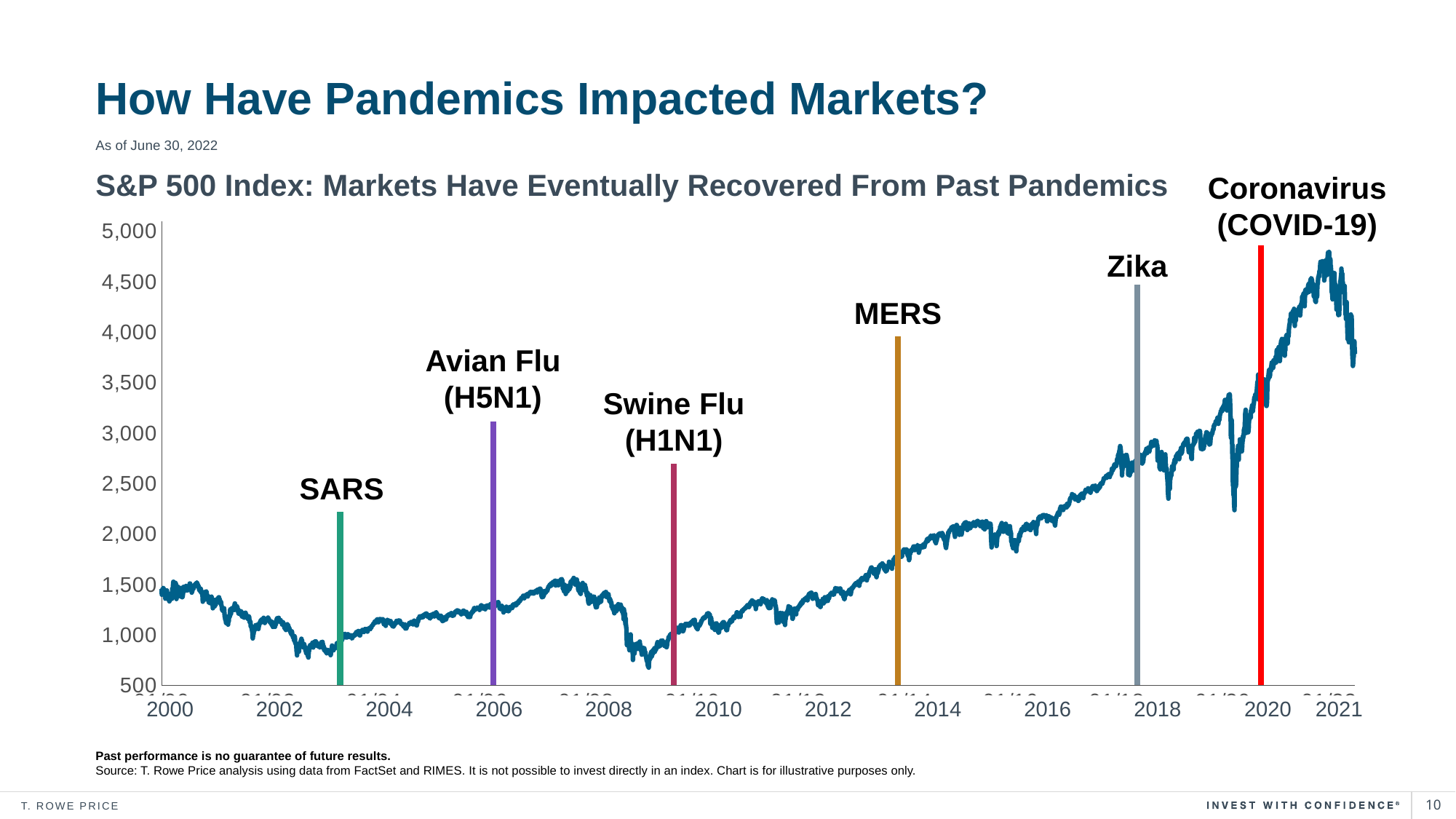
Is the S&P 500 Index value at the Zika marker greater or less than 2,500? greater What is the title of the chart? S&P 500 Index: Markets Have Eventually Recovered From Past Pandemics How many pandemics are marked with vertical lines on the chart? 6 Is the S&P 500 Index value at the Coronavirus (COVID-19) marker greater or less than 3,000? greater What kind of chart is shown on the slide? line chart Is the highest point of the S&P 500 Index on the chart greater or less than 4,500? greater What is the highest value shown on the y axis of the chart? 5,000 Which pandemic marker appears earliest on the x axis? SARS Does the S&P 500 Index generally rise or fall from 2000 to 2021 on the chart? rise